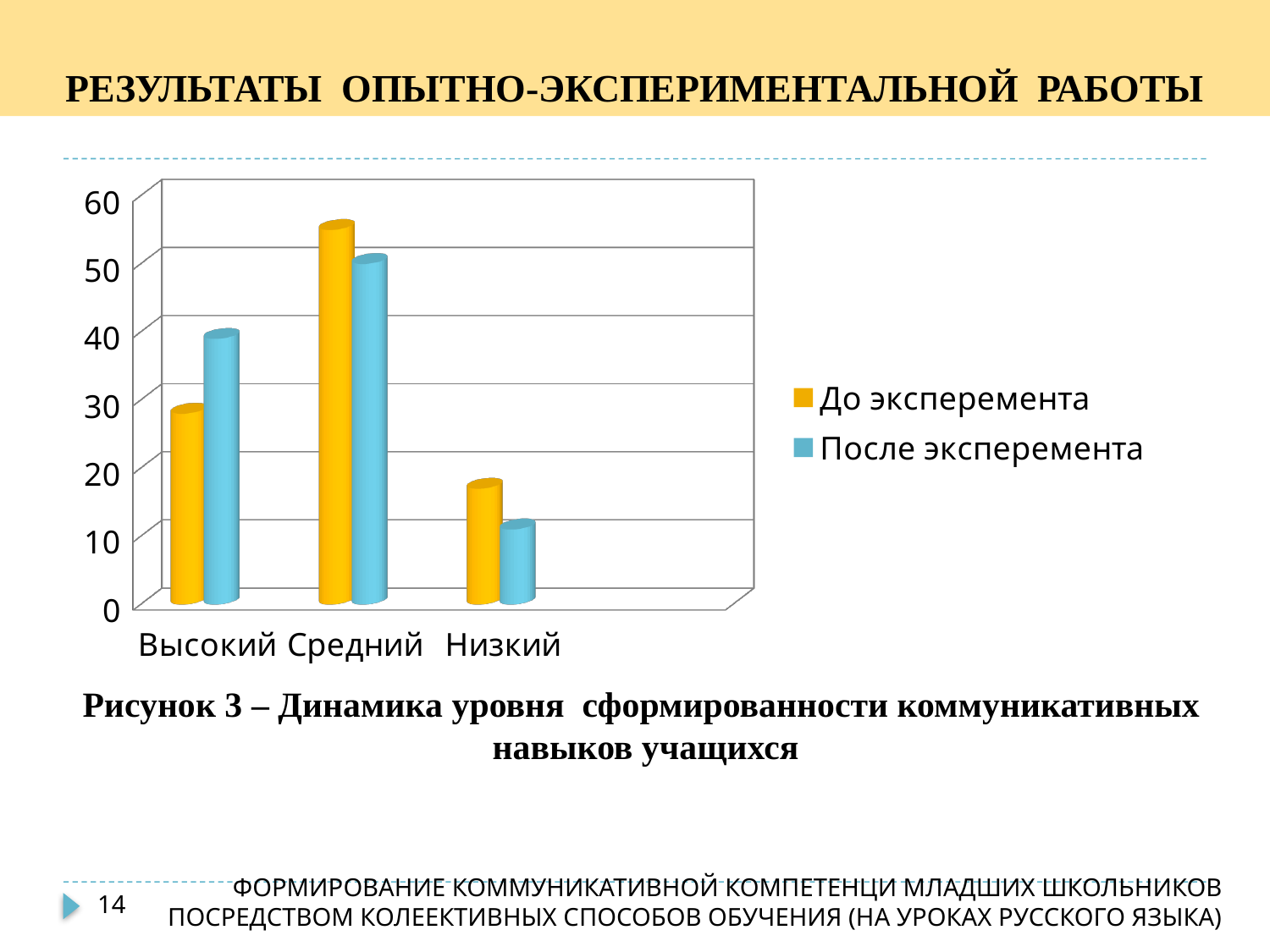
What is the figure number given in the caption below the chart? Рисунок 3 How many series does the chart legend list? 2 Is the value for "Низкий" in the series "После эксперемента" greater or less than 20? less Is the value for "Средний" in the series "До эксперемента" greater or less than 50? greater Is the value for "Высокий" in the series "До эксперемента" greater or less than 30? less What are the two legend entries of the chart? До эксперемента, После эксперемента What kind of chart is shown on the slide? bar chart For the category "Высокий", which series has the larger value: "До эксперемента" or "После эксперемента"? После эксперемента For the category "Средний", which series has the larger value: "До эксперемента" or "После эксперемента"? До эксперемента How many categories are shown on the x axis of the chart? 3 Which category has the highest value for the series "До эксперемента"? Средний Which category has the lowest value for the series "После эксперемента"? Низкий